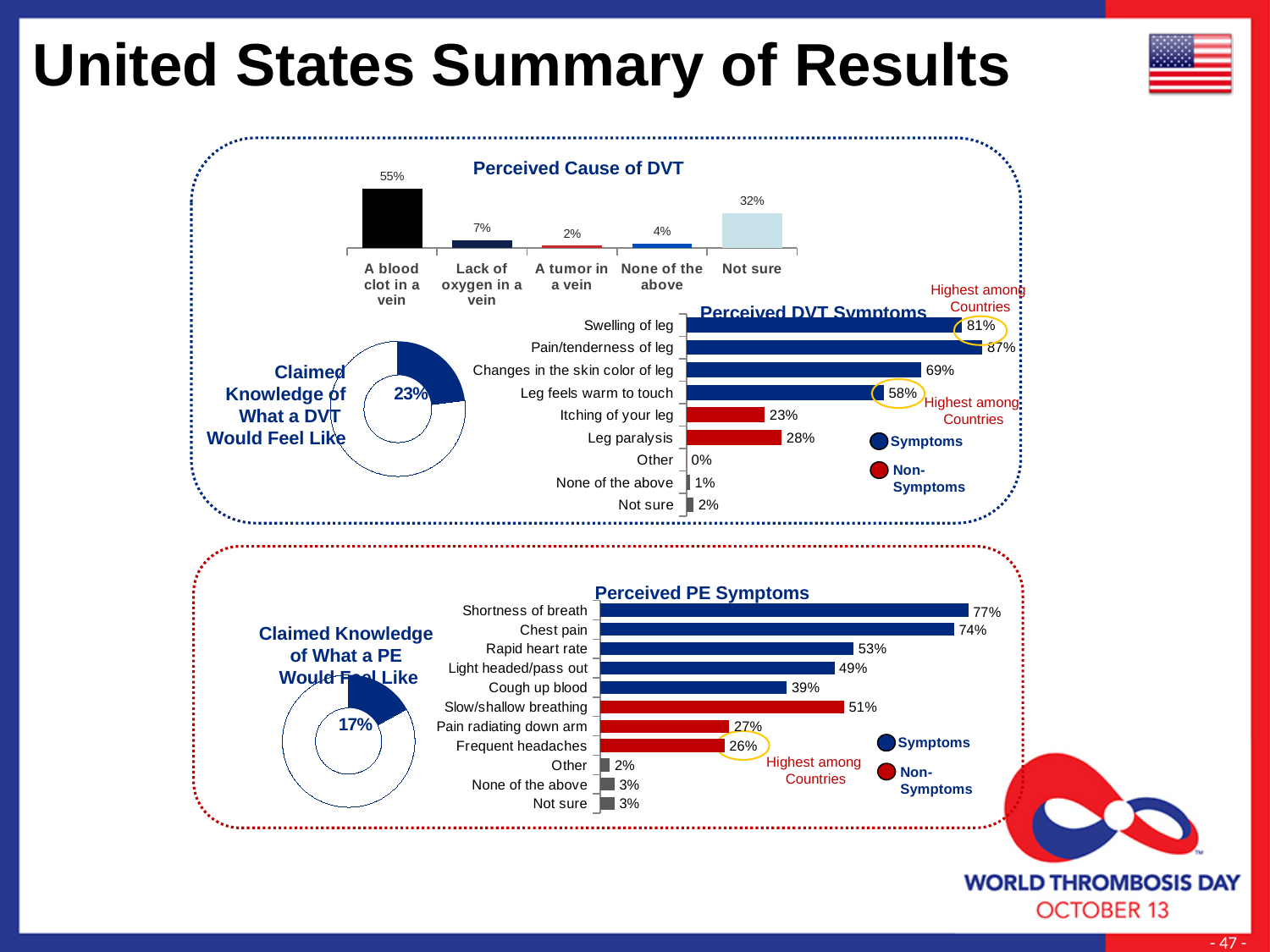
In the Perceived PE Symptoms chart, what is the difference between "Shortness of breath" and "Chest pain"? 3% In the Perceived Cause of DVT chart, which category has the lowest value? A tumor in a vein In the Perceived DVT Symptoms chart, what percentage is shown for "Pain/tenderness of leg"? 87% What percentage is shown in the Claimed Knowledge of What a PE Would Feel Like donut chart? 17% What kind of chart is the Perceived PE Symptoms chart? Bar chart In the Perceived DVT Symptoms chart, which is larger: "Itching of your leg" or "Leg paralysis"? Leg paralysis In the Perceived DVT Symptoms chart, which symptom has the highest value? Pain/tenderness of leg In the Perceived PE Symptoms chart, what percentage is shown for "Cough up blood"? 39% In the Perceived Cause of DVT chart, what percentage is shown for "A blood clot in a vein"? 55% In the Perceived Cause of DVT chart, how many categories are shown? 5 In the Perceived DVT Symptoms chart, how many series does the legend list? 2 In the Perceived Cause of DVT chart, what is the difference between "A blood clot in a vein" and "Not sure"? 23%